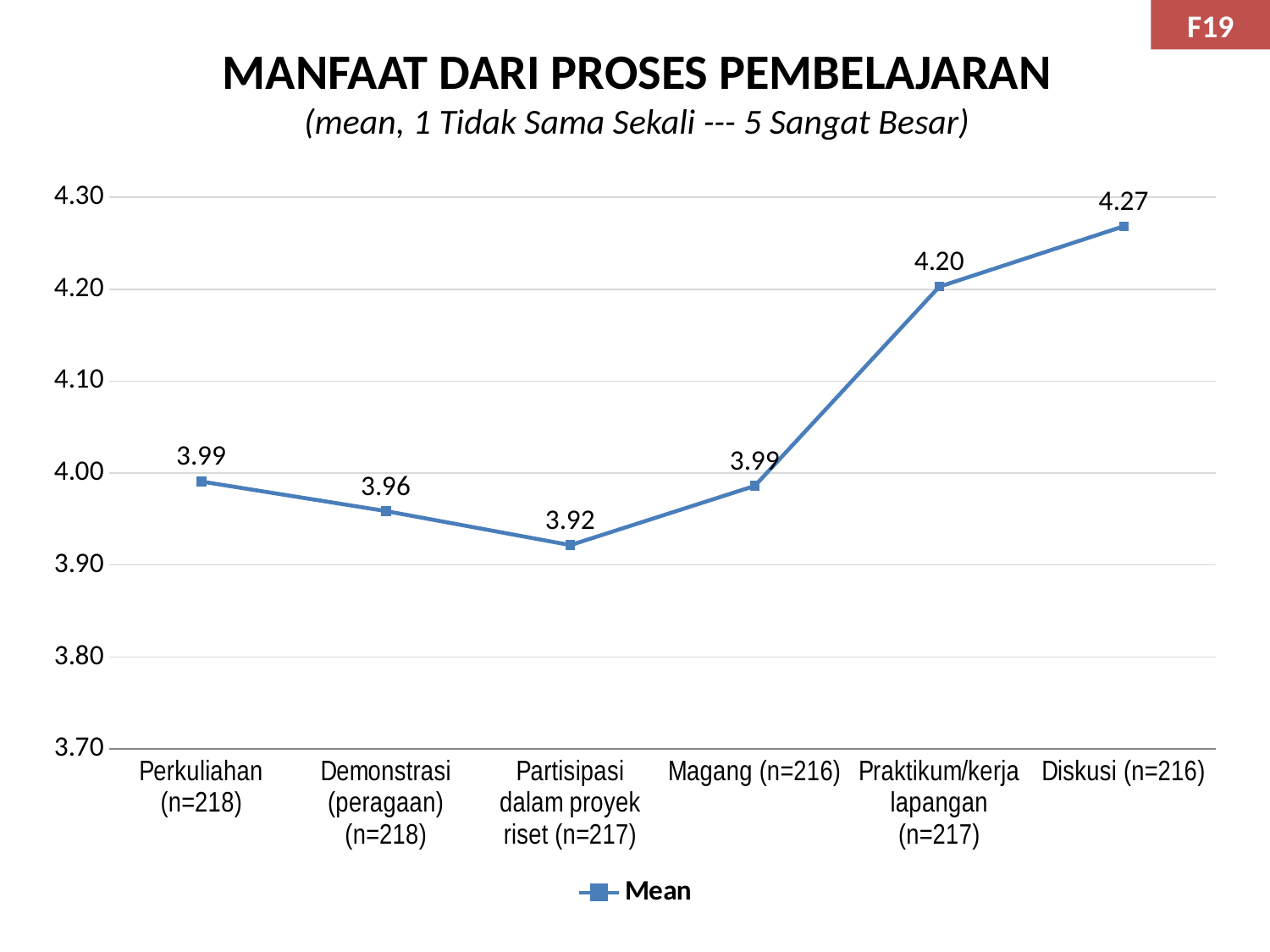
What is the mean value for Praktikum/kerja lapangan (n=217)? 4.20 Which category has the highest mean value? Diskusi (n=216) What is the mean value for Demonstrasi (peragaan) (n=218)? 3.96 Which has a larger mean value, Praktikum/kerja lapangan (n=217) or Magang (n=216)? Praktikum/kerja lapangan (n=217) What kind of chart is shown on the slide? line chart What is the difference between the mean values for Diskusi (n=216) and Partisipasi dalam proyek riset (n=217)? 0.35 What is the mean value for Diskusi (n=216)? 4.27 What is the mean value for Partisipasi dalam proyek riset (n=217)? 3.92 What series name does the legend show? Mean Which category has the lowest mean value? Partisipasi dalam proyek riset (n=217) Is the mean value for Magang (n=216) greater or less than 4.10? less How many categories are plotted on the chart? 6